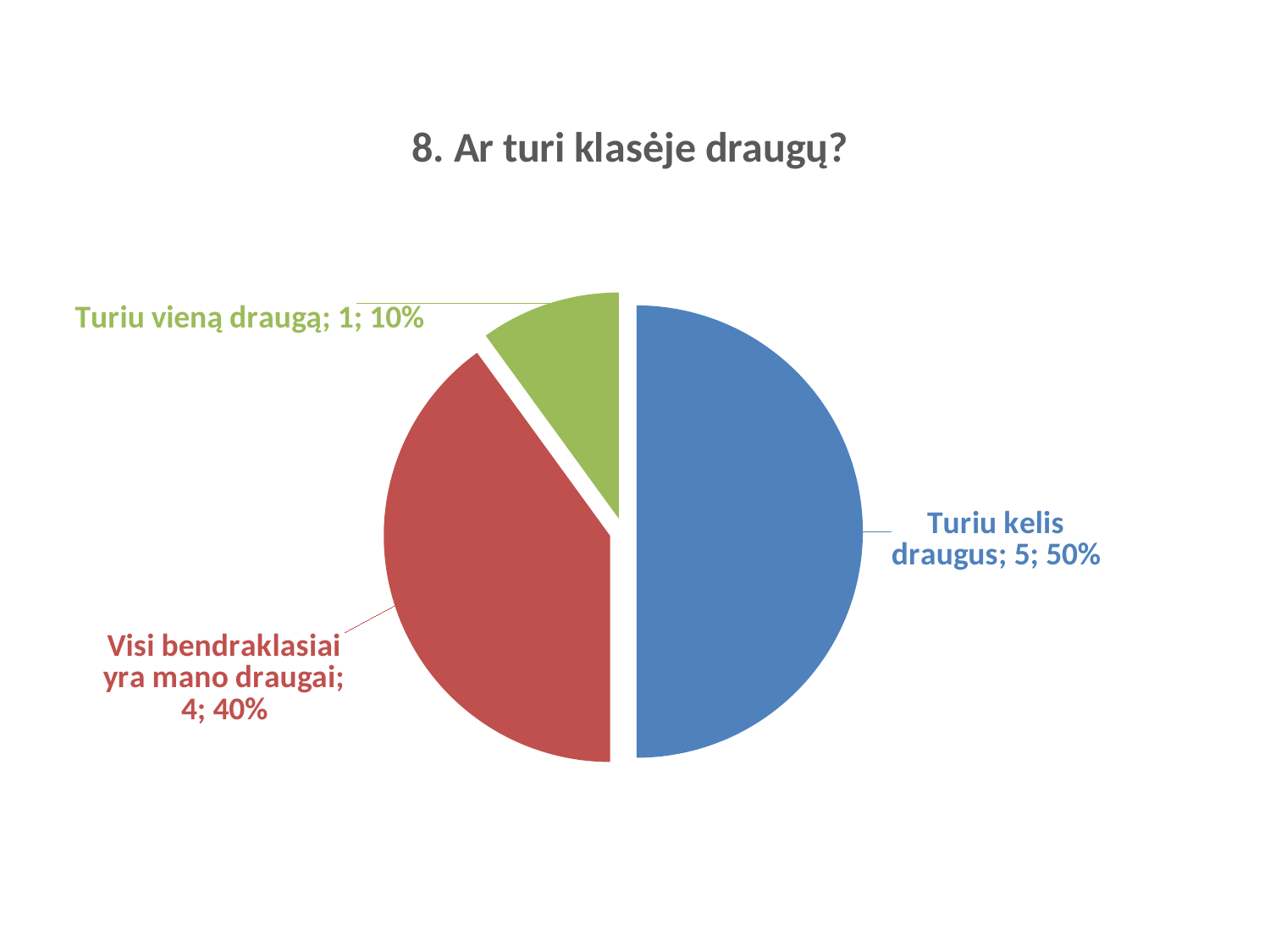
What kind of chart is shown on the slide? Pie chart What percentage share does "Visi bendraklasiai yra mano draugai" have? 40% Which category has the smallest slice? Turiu vieną draugą What colour is the slice for "Turiu vieną draugą"? Green Which is larger: "Visi bendraklasiai yra mano draugai" or "Turiu vieną draugą"? Visi bendraklasiai yra mano draugai What is the title of the chart? 8. Ar turi klasėje draugų? How many slices does the pie chart have? 3 What is the count for "Turiu kelis draugus"? 5 What is the total count across all slices? 10 What is the difference in count between "Turiu kelis draugus" and "Visi bendraklasiai yra mano draugai"? 1 What is the count for "Turiu vieną draugą"? 1 Which category has the largest slice? Turiu kelis draugus